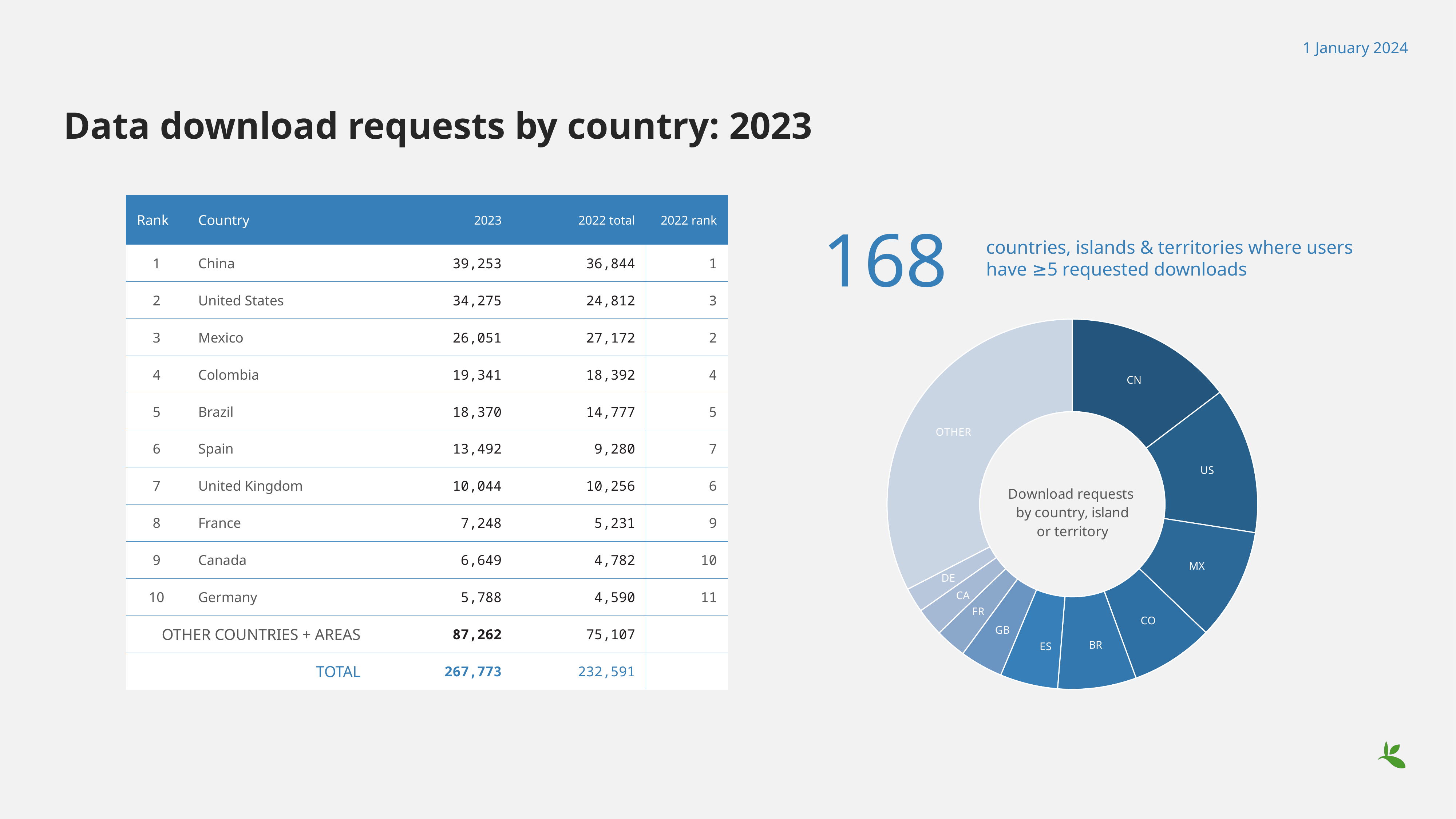
What is the total number of download requests in 2023 represented by the whole donut chart? 267,773 In the donut chart, which segment is larger, US or MX? US Which segment of the donut chart is the smallest? DE How many segments does the donut chart have? 11 What kind of chart is shown on the right of the slide? Donut (pie) chart Among the individual country segments in the donut chart, which is the largest? CN How many 2023 download requests does the CN segment of the donut chart represent, according to the table? 39,253 Which segment of the donut chart is the largest? OTHER How many 2023 download requests does the OTHER segment of the donut chart represent, according to the table? 87,262 What text is written in the centre of the donut chart? Download requests by country, island or territory In the donut chart, which segment is larger, ES or BR? BR What is the difference in 2023 download requests between China and the United States? 4,978